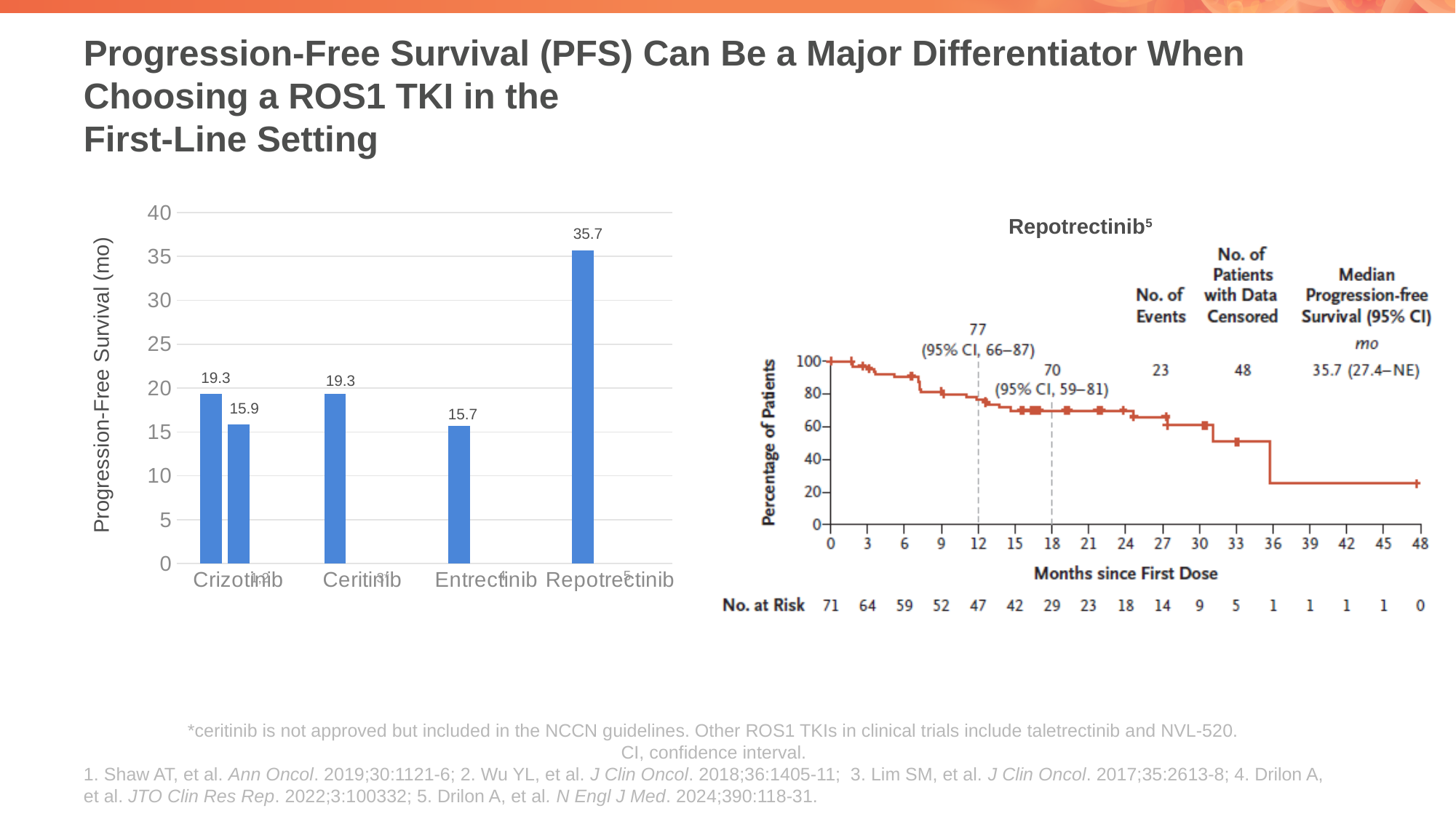
In the bar chart on the left, which drug has the lowest progression-free survival bar? Entrectinib In the Repotrectinib chart on the right, what is the percentage of patients at 12 months? 77 In the bar chart on the left, what is the difference between the Repotrectinib value and the Entrectinib value? 20.0 In the bar chart on the left, what is the label of the y axis? Progression-Free Survival (mo) In the Repotrectinib chart on the right, what is the number of events? 23 In the bar chart on the left, what is the progression-free survival value for Entrectinib? 15.7 In the bar chart on the left, what is the progression-free survival value for Repotrectinib? 35.7 In the Repotrectinib chart on the right, what is the median progression-free survival (95% CI) in months? 35.7 (27.4–NE) What type of chart is shown on the left side of the slide? Bar chart In the bar chart on the left, which drug has the highest progression-free survival? Repotrectinib In the bar chart on the left, what is the progression-free survival value for Ceritinib? 19.3 In the bar chart on the left, how many drug categories are shown on the x axis? 4